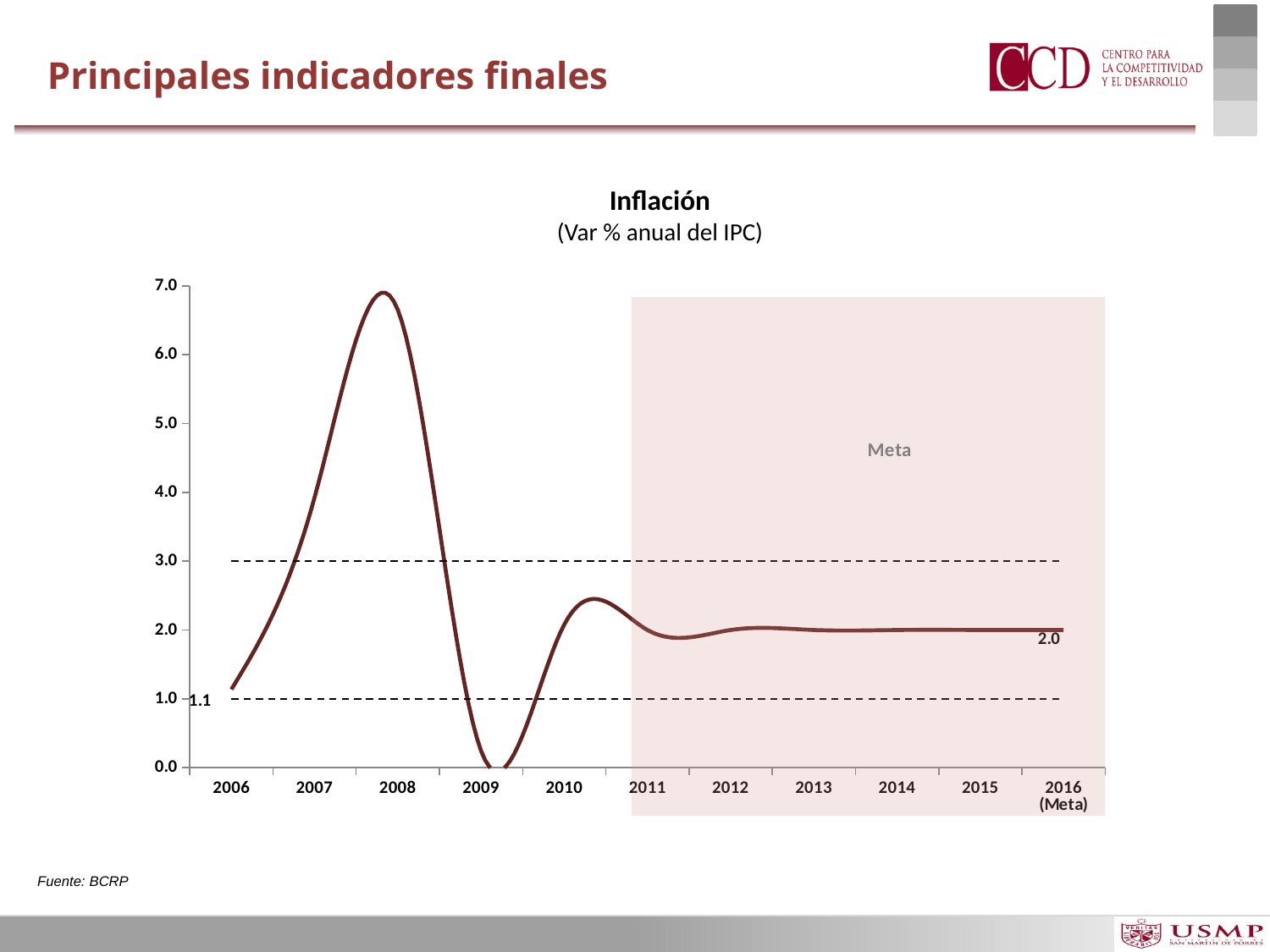
Is the inflation value for 2010 greater or less than 3.0? less What is the title of the chart? Inflación Does the inflation line rise or fall between 2006 and 2008? rises What kind of chart is shown on the slide? line chart What is the inflation value shown for 2016 (Meta)? 2.0 How many years are labelled on the x axis? 11 What is the inflation value shown for 2006? 1.1 In which year does the inflation line reach its lowest point? 2009 In which year does the inflation line reach its highest point? 2008 Which has the larger labelled value, 2006 or 2016 (Meta)? 2016 (Meta) Is the inflation value for 2008 greater or less than 6.0? greater What is the difference between the labelled values for 2016 (Meta) and 2006? 0.9